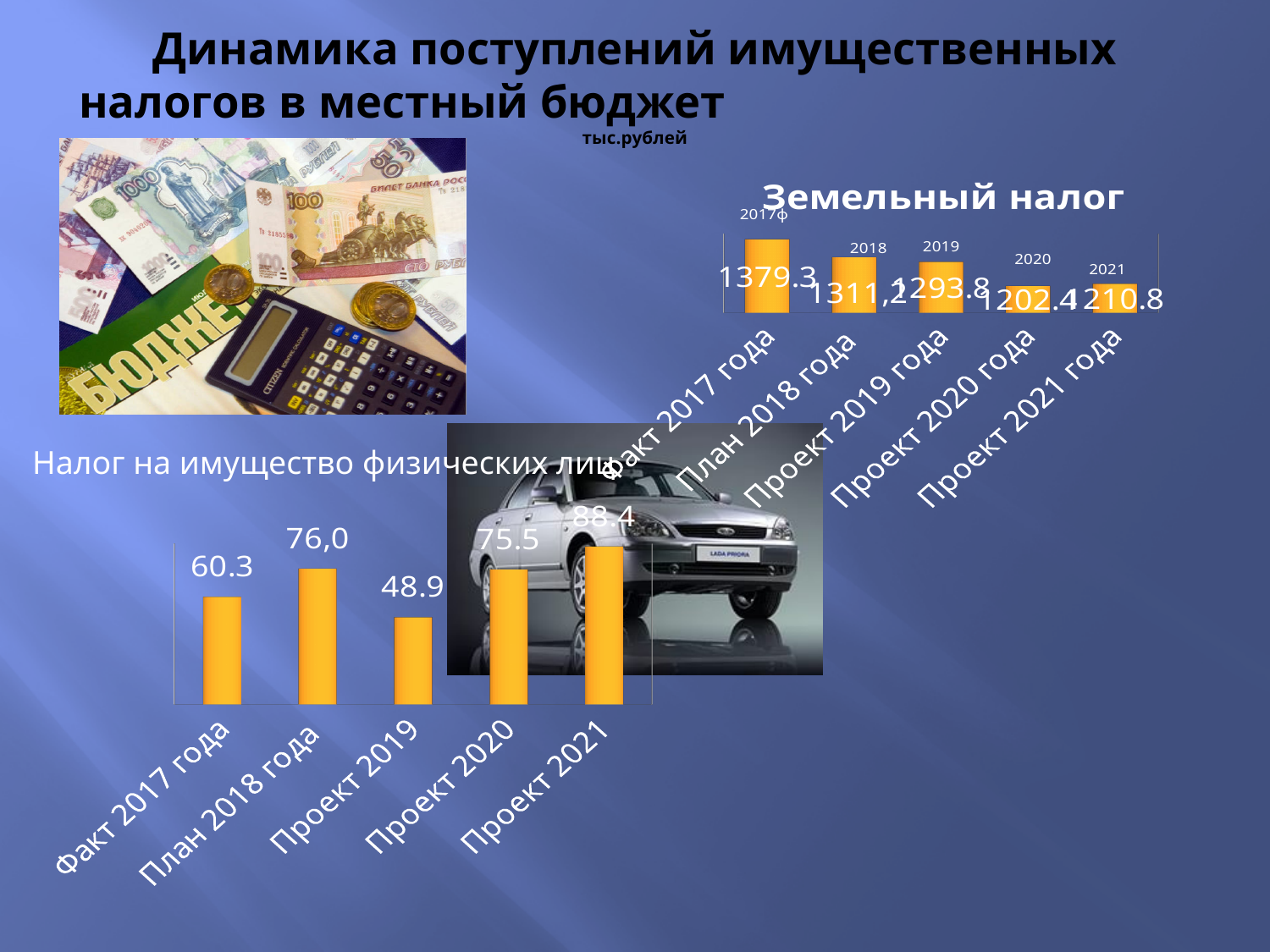
In the 'Налог на имущество физических лиц' chart, what is the value for Проект 2021? 88.4 In the 'Земельный налог' chart, what is the value for Проект 2020 года? 1202.4 What kind of chart is the 'Земельный налог' chart? Bar chart In the 'Земельный налог' chart, what is the difference between the values for Факт 2017 года and Проект 2020 года? 176.9 In the 'Налог на имущество физических лиц' chart, which is larger: the value for Факт 2017 года or the value for Проект 2019? Факт 2017 года In the 'Земельный налог' chart, which category has the lowest value? Проект 2020 года In the 'Земельный налог' chart, which category has the highest value? Факт 2017 года In the 'Налог на имущество физических лиц' chart, what is the difference between the values for Проект 2021 and Проект 2019? 39.5 In the 'Земельный налог' chart, what is the value for Факт 2017 года? 1379.3 In the 'Налог на имущество физических лиц' chart, what is the value for Проект 2019? 48.9 In the 'Налог на имущество физических лиц' chart, which category has the lowest value? Проект 2019 How many categories are shown in the 'Налог на имущество физических лиц' chart? 5